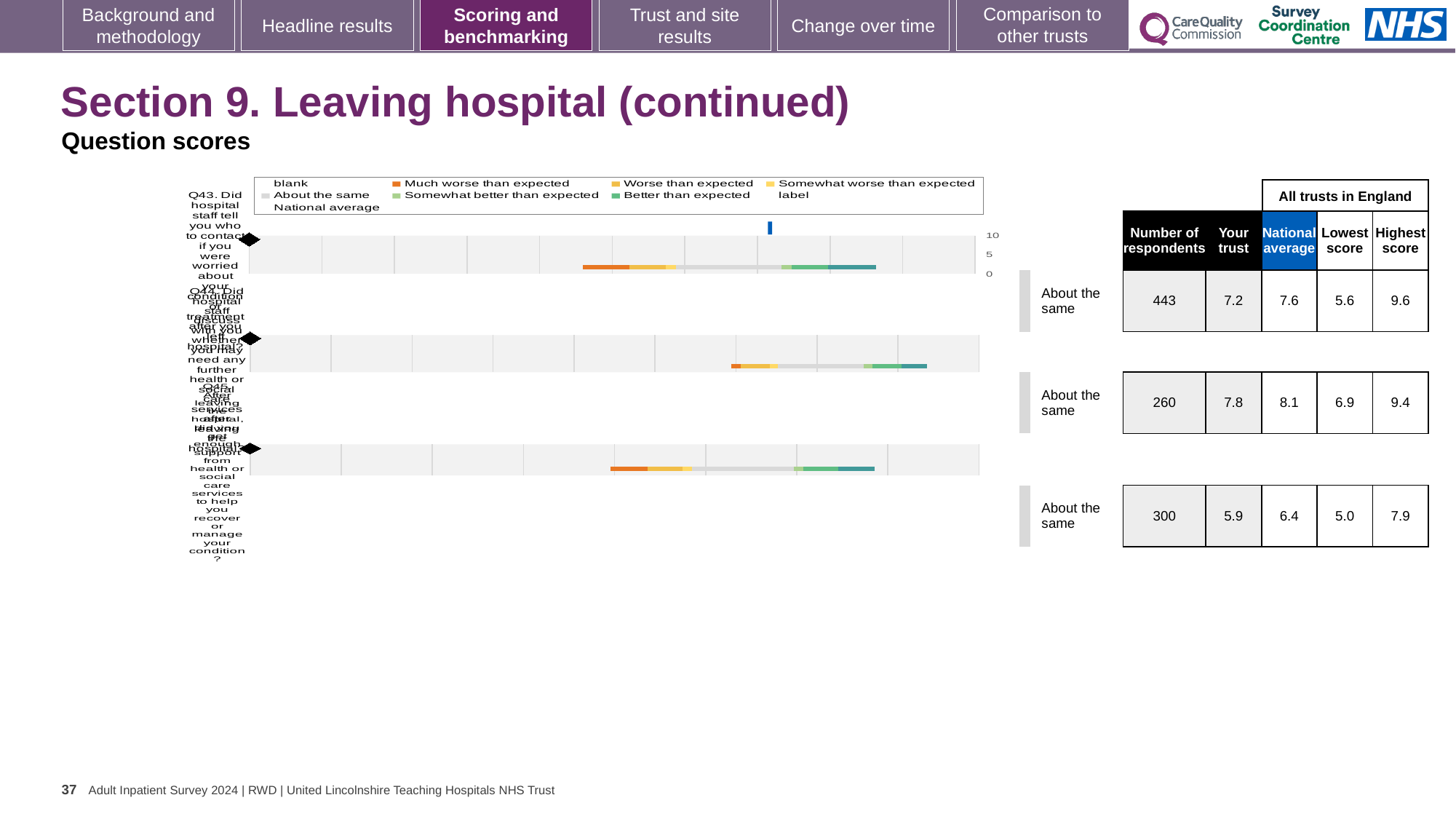
For the second chart (Q44), which is larger: the 'Your trust' score or the national average? national average What kind of chart is used to show the question scores on this slide? bar chart Which of the three questions has the lowest 'Your trust' score? Q45 For the second chart (Q44), what is the national average score shown in the table? 8.1 How many question score charts are shown on the slide? 3 For the first chart (Q43), what is the difference between the national average and the 'Your trust' score? 0.4 What is the highest value shown on the score axis above the first chart? 10 For the third chart (Q45), how many respondents are shown in the table? 300 For the first chart (Q43), what is the 'Your trust' score shown in the table? 7.2 In the chart legend, what colour represents 'Much worse than expected'? orange Which of the three questions has the highest 'Your trust' score? Q44